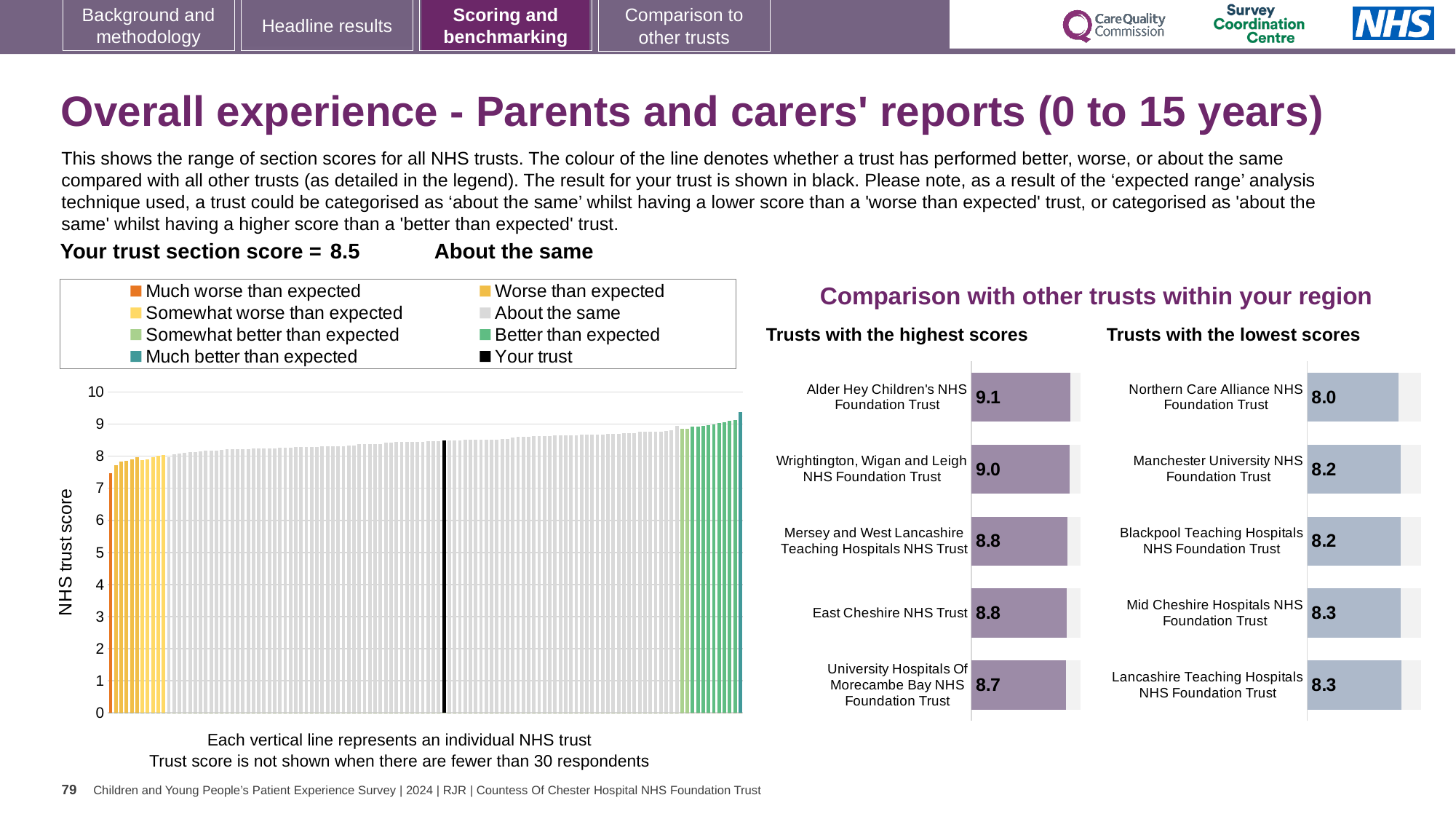
In the 'Trusts with the lowest scores' chart, what is the score for Northern Care Alliance NHS Foundation Trust? 8.0 In the 'Trusts with the lowest scores' chart, which trust has the lowest score? Northern Care Alliance NHS Foundation Trust In the large chart on the left showing all NHS trusts, is the value for the black 'Your trust' bar greater or less than 8? greater In the 'Trusts with the lowest scores' chart, what is the score for Lancashire Teaching Hospitals NHS Foundation Trust? 8.3 In the 'Trusts with the highest scores' chart, what is the difference between the scores of Alder Hey Children's NHS Foundation Trust and University Hospitals Of Morecambe Bay NHS Foundation Trust? 0.4 In the 'Trusts with the highest scores' chart, how many trusts are shown? 5 What kind of chart is the large chart on the left showing all NHS trusts? bar chart In the large chart on the left showing all NHS trusts, do the trust scores rise or fall from left to right along the x axis? rise In the 'Trusts with the highest scores' chart, what is the score for Alder Hey Children's NHS Foundation Trust? 9.1 In the 'Trusts with the highest scores' chart, which trust has the highest score? Alder Hey Children's NHS Foundation Trust In the 'Trusts with the lowest scores' chart, which has the larger score: Manchester University NHS Foundation Trust or Mid Cheshire Hospitals NHS Foundation Trust? Mid Cheshire Hospitals NHS Foundation Trust How many entries does the legend above the large chart on the left list? 8